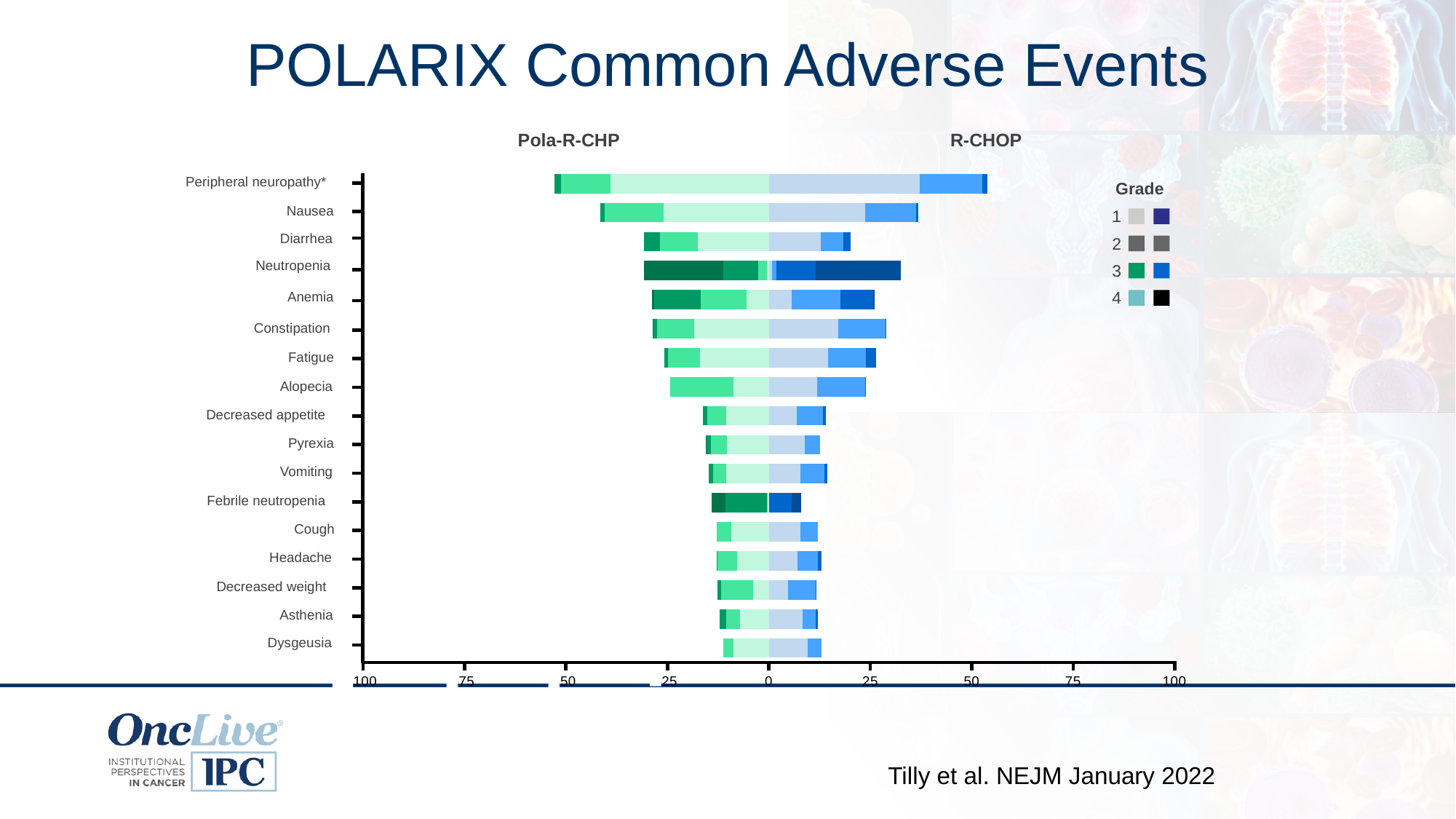
For Febrile neutropenia, which arm has the larger value, Pola-R-CHP or R-CHOP? Pola-R-CHP How many adverse events are listed on the chart? 17 Is the Pola-R-CHP value for Peripheral neuropathy* greater or less than 50? greater Which adverse event has the longest bar for the Pola-R-CHP arm? Peripheral neuropathy* Is the R-CHOP value for Neutropenia greater or less than 25? greater For Diarrhea, which arm has the larger value, Pola-R-CHP or R-CHOP? Pola-R-CHP Is the Pola-R-CHP value for Nausea greater or less than 50? less How many grades does the legend list? 4 Which two treatment arms are compared in the chart? Pola-R-CHP and R-CHOP What kind of chart is shown on the slide? Bar chart Which adverse event has the shortest bar for the R-CHOP arm? Febrile neutropenia